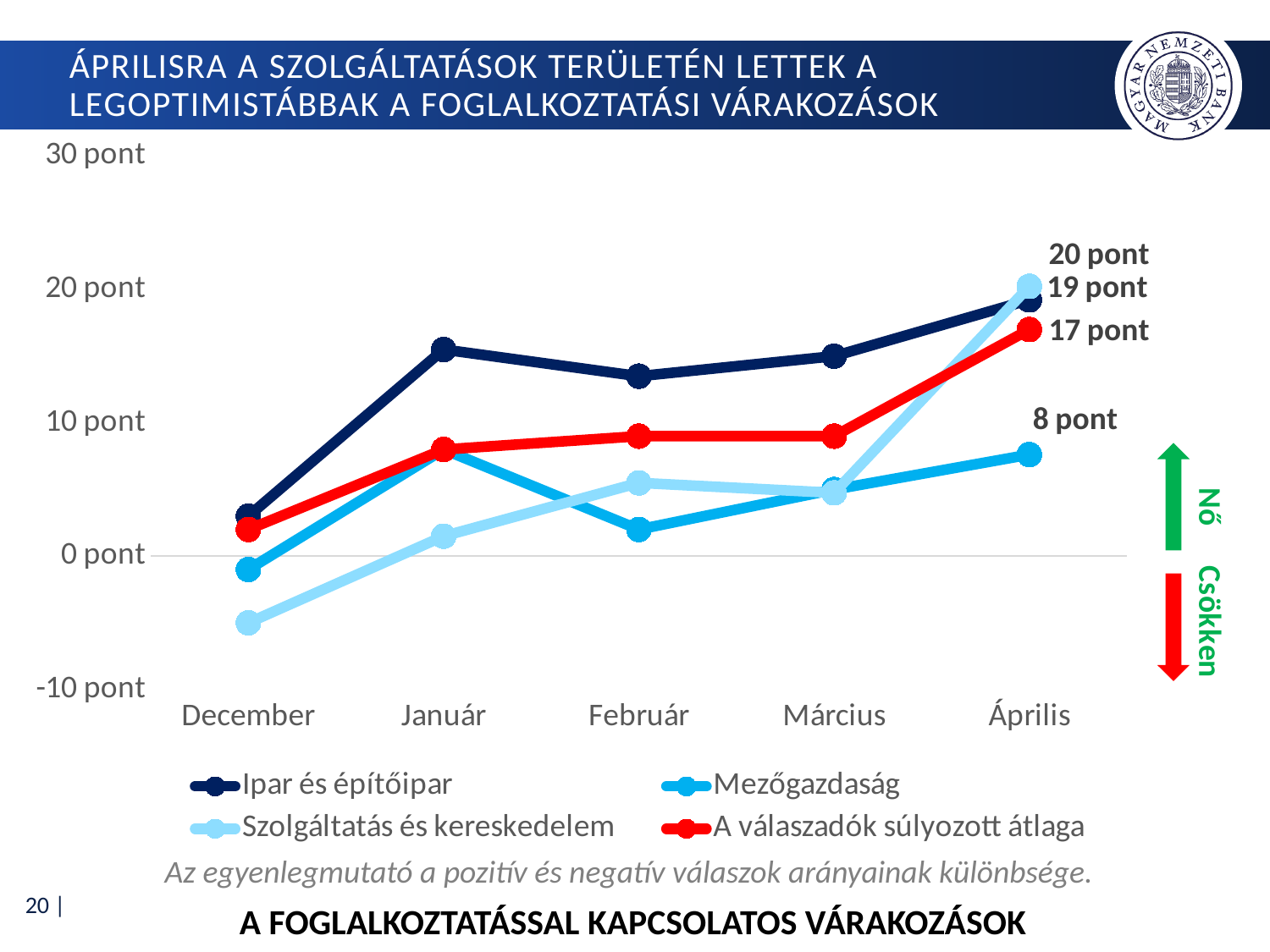
How many months are shown on the x axis? 5 What is the value for Ipar és építőipar in Április? 19 pont Which is larger in Február: Ipar és építőipar or Mezőgazdaság? Ipar és építőipar Which series has the lowest value in Április? Mezőgazdaság How many series does the legend list? 4 Is the value for Szolgáltatás és kereskedelem in December greater or less than 0 pont? less What kind of chart is shown on the slide? line chart Is the value for Ipar és építőipar in Január greater or less than 10 pont? greater What is the value for A válaszadók súlyozott átlaga in Április? 17 pont What is the value for Mezőgazdaság in Április? 8 pont What is the value for Szolgáltatás és kereskedelem in Április? 20 pont What is the difference between Szolgáltatás és kereskedelem and Mezőgazdaság in Április? 12 pont